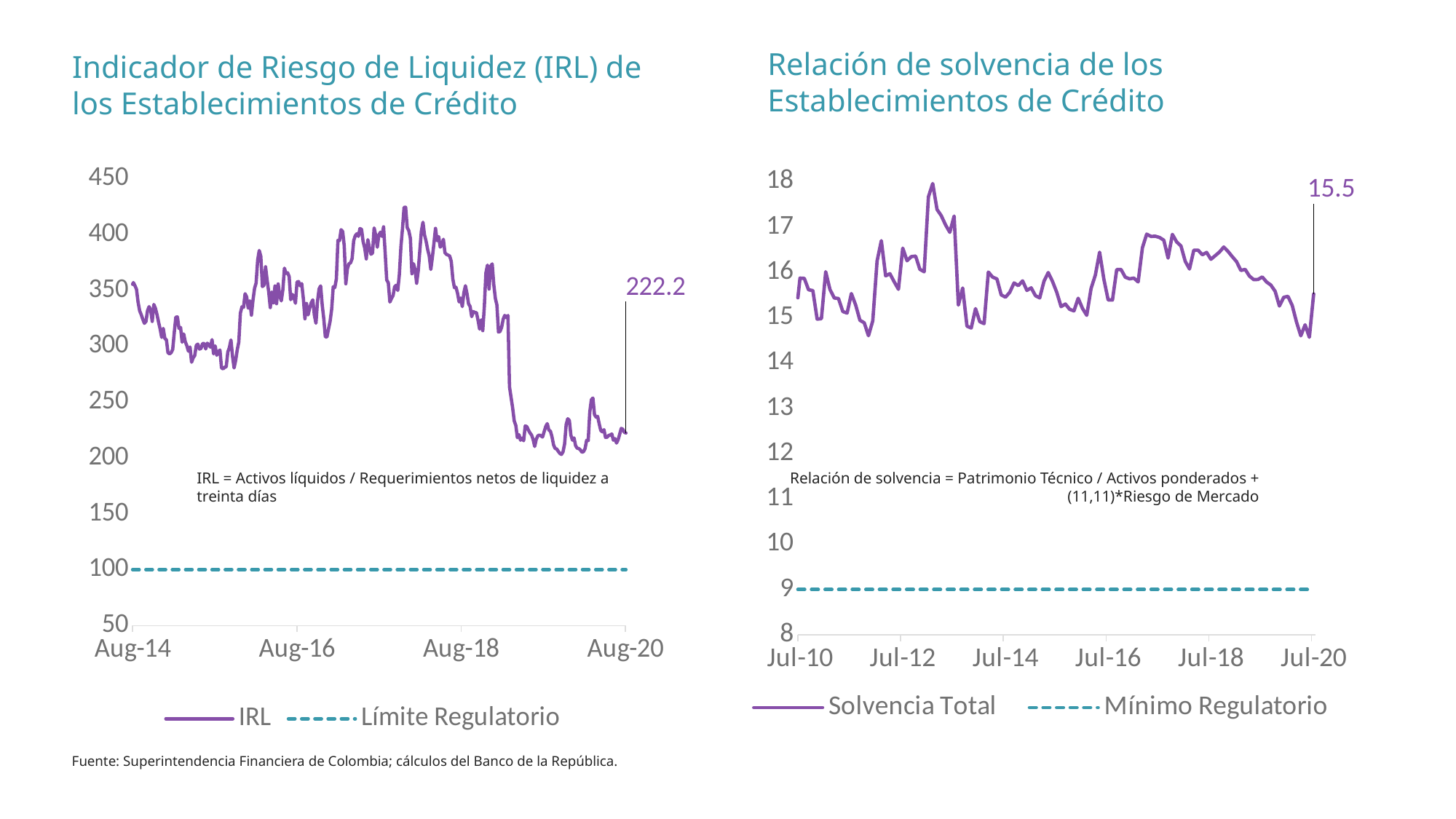
What kind of chart is the left chart (Indicador de Riesgo de Liquidez)? Line chart In the left chart, at what level does the dashed Límite Regulatorio line sit? 100 In the right chart, by how much does the final Solvencia Total value of 15.5 exceed the Mínimo Regulatorio of 9? 6.5 In the right chart, at what level does the dashed Mínimo Regulatorio line sit? 9 In the right chart (Relación de solvencia), what is the labelled value of Solvencia Total at the end of the series (Jul-20)? 15.5 In the left chart, is the IRL value around Aug-16 greater or less than 300? greater How many series does the legend of the right chart (Relación de solvencia) list? 2 What are the two legend entries of the left chart? IRL and Límite Regulatorio In the right chart, is the Solvencia Total value at Jul-10 greater or less than 14? greater In the left chart, by how much does the final IRL value of 222.2 exceed the Límite Regulatorio of 100? 122.2 In the left chart, does the IRL series end higher or lower than it starts at Aug-14? Lower In the left chart (Indicador de Riesgo de Liquidez), what is the labelled value of the IRL at the end of the series (Aug-20)? 222.2